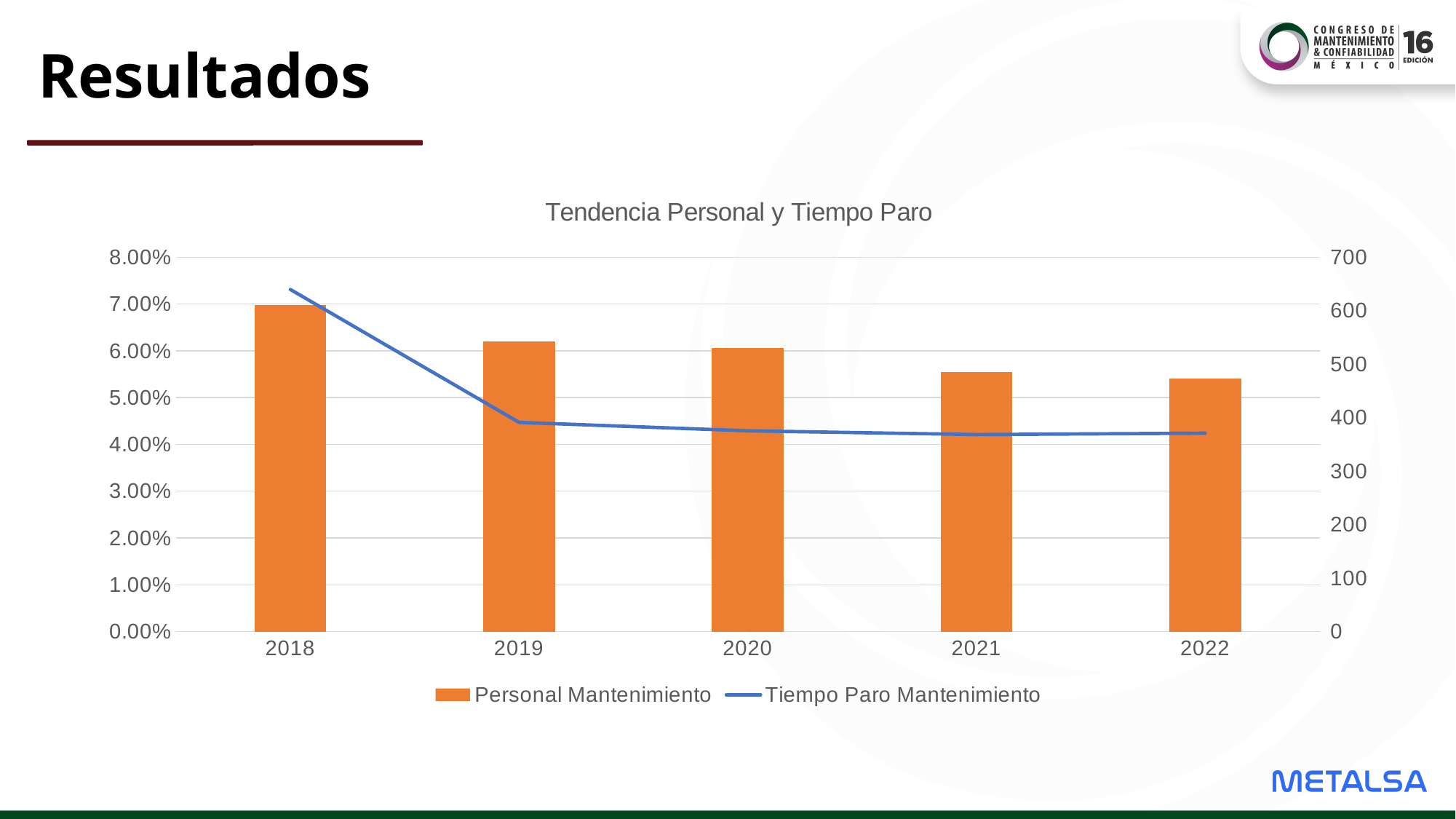
In which year is the Tiempo Paro Mantenimiento line at its highest? 2018 Which year has the highest Personal Mantenimiento bar? 2018 How many series does the legend list? 2 Does the Personal Mantenimiento series rise or fall from 2018 to 2022? fall What kind of chart is this? Combined bar and line chart Which year has the lowest Personal Mantenimiento bar? 2022 What is the title of the chart? Tendencia Personal y Tiempo Paro How many years are shown on the x axis? 5